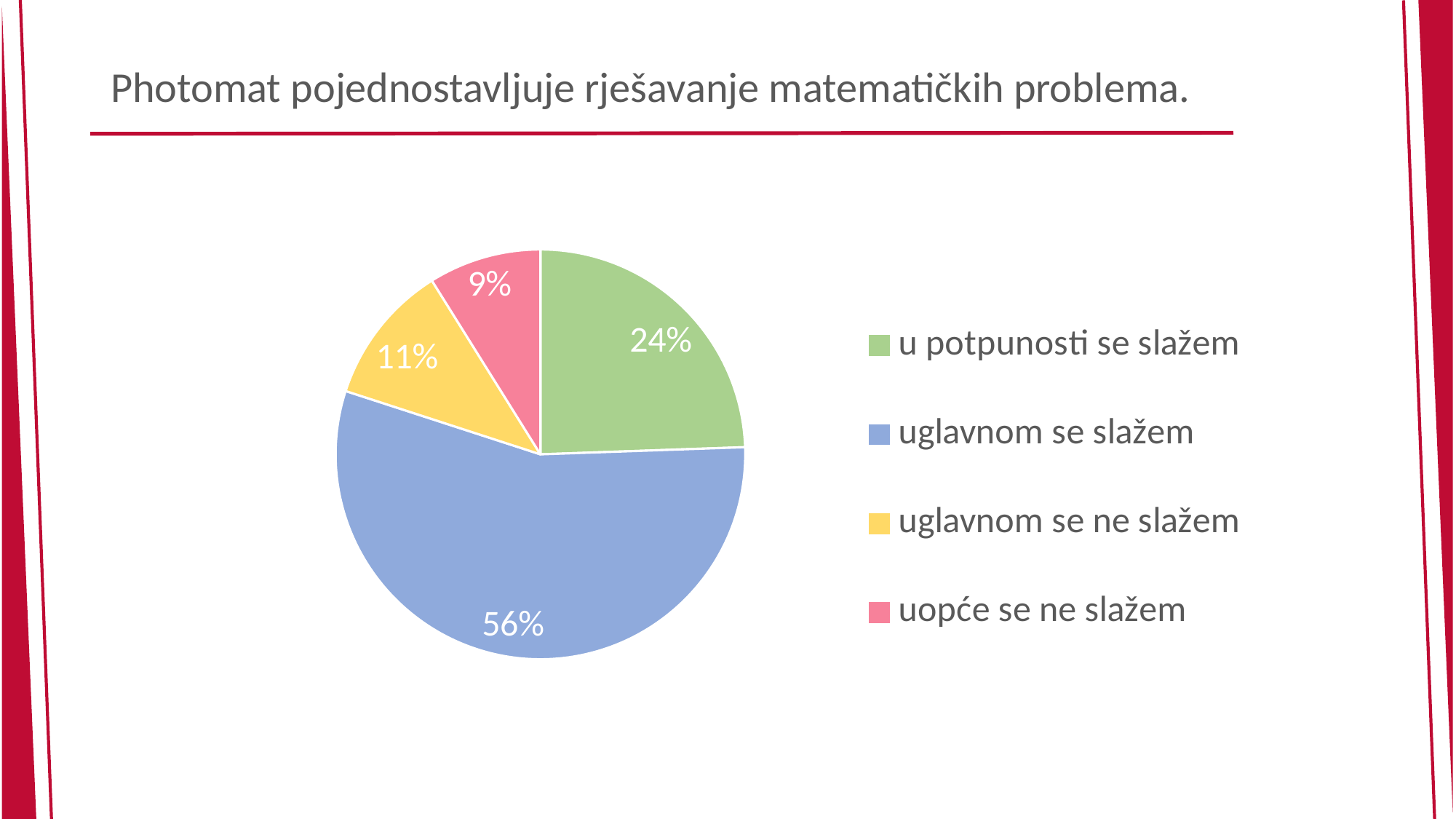
What share of the pie is labelled "uglavnom se ne slažem"? 11% How many categories does the pie chart show? 4 Which category has the smallest slice of the pie? uopće se ne slažem What is the difference in percentage points between "uglavnom se slažem" and "u potpunosti se slažem"? 32 Which category has the largest slice of the pie? uglavnom se slažem What is the combined share of "u potpunosti se slažem" and "uglavnom se slažem"? 80% What share of the pie is labelled "uglavnom se slažem"? 56% Which is larger: the slice for "uglavnom se ne slažem" or the slice for "uopće se ne slažem"? uglavnom se ne slažem What share of the pie is labelled "uopće se ne slažem"? 9% What share of the pie is labelled "u potpunosti se slažem"? 24% What kind of chart is shown on the slide? pie chart What is the title of the chart on the slide? Photomat pojednostavljuje rješavanje matematičkih problema.